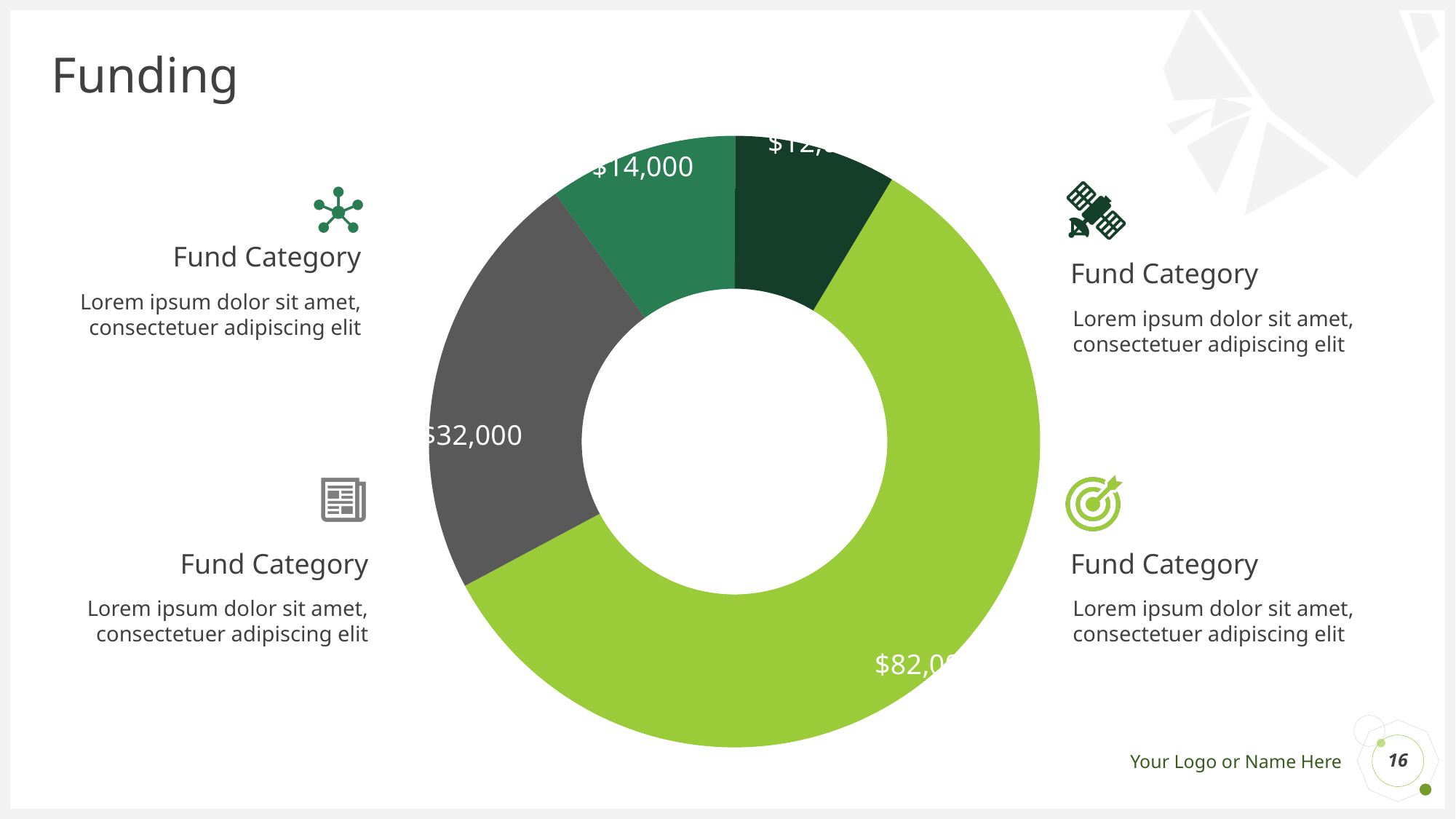
How many slices does the donut chart have? 4 What is the title of the slide containing the chart? Funding What value is labelled on the gray slice of the donut chart? $32,000 What value is labelled on the teal green slice at the top left of the donut chart? $14,000 What kind of chart is shown on the slide? donut chart Which is larger, the light green slice or the gray slice? the light green slice What colour is the largest slice of the donut chart? light green Which is larger, the gray slice or the teal green slice labelled $14,000? the gray slice Which slice of the donut chart is the largest? the light green slice What is the difference between the gray slice ($32,000) and the teal green slice ($14,000)? $18,000